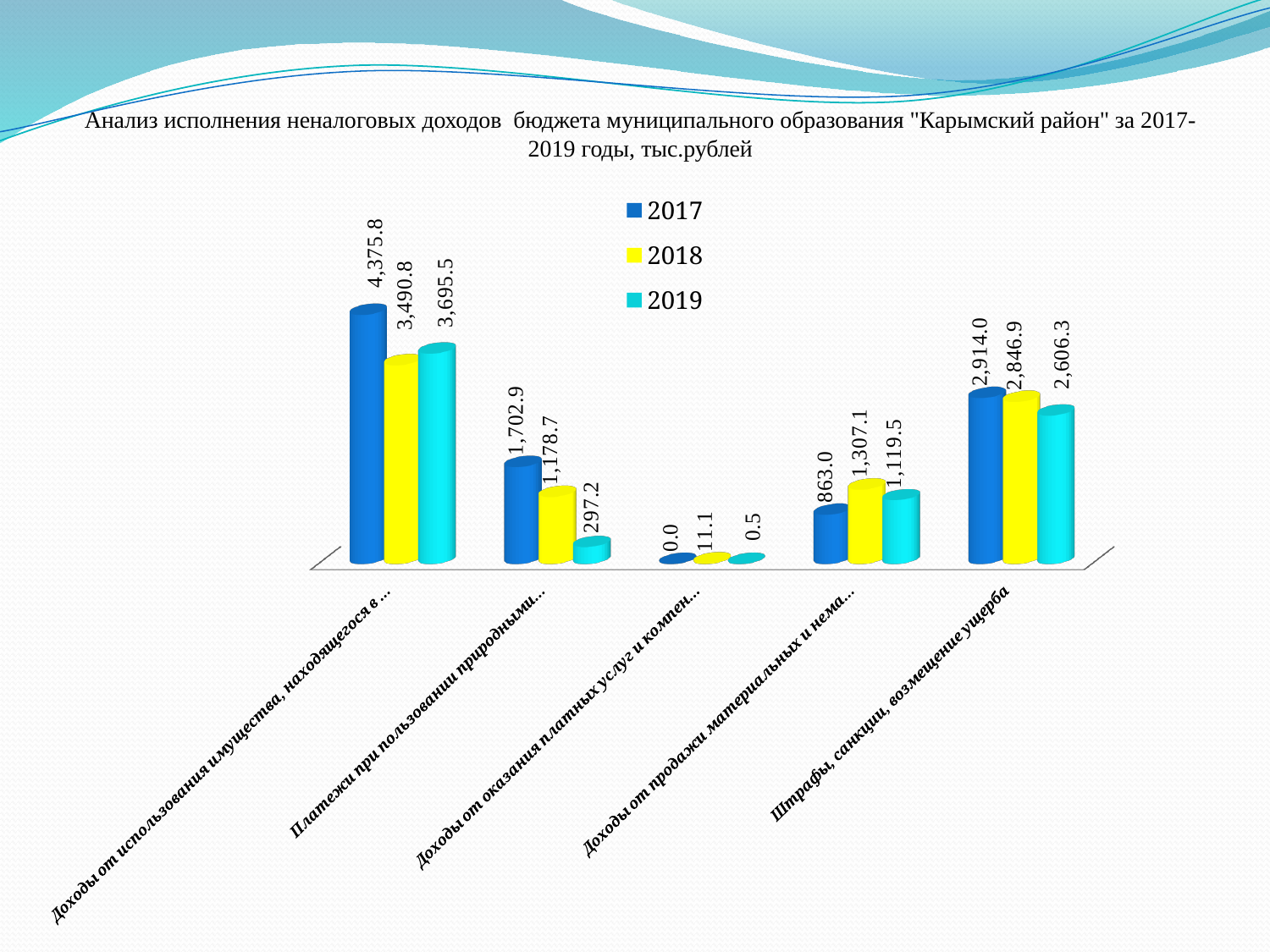
What is the difference between the 2017 and 2018 values for "Доходы от использования имущества, находящегося в ..."? 885.0 Which category has the lowest 2018 value? Доходы от оказания платных услуг и компен... Which category has the highest 2017 value? Доходы от использования имущества, находящегося в ... How many series does the legend list? 3 What is the 2019 value for the category "Платежи при пользовании природными..."? 297.2 For "Платежи при пользовании природными...", do the values rise or fall from 2017 to 2019? Fall What kind of chart is shown on the slide? Bar chart For "Доходы от продажи материальных и нема...", which year has the larger value, 2018 or 2019? 2018 What is the 2018 value for the category "Доходы от оказания платных услуг и компен..."? 11.1 What is the difference between the 2017 and 2019 values for "Штрафы, санкции, возмещение ущерба"? 307.7 How many categories are shown on the x axis? 5 What is the 2017 value for "Штрафы, санкции, возмещение ущерба"? 2,914.0